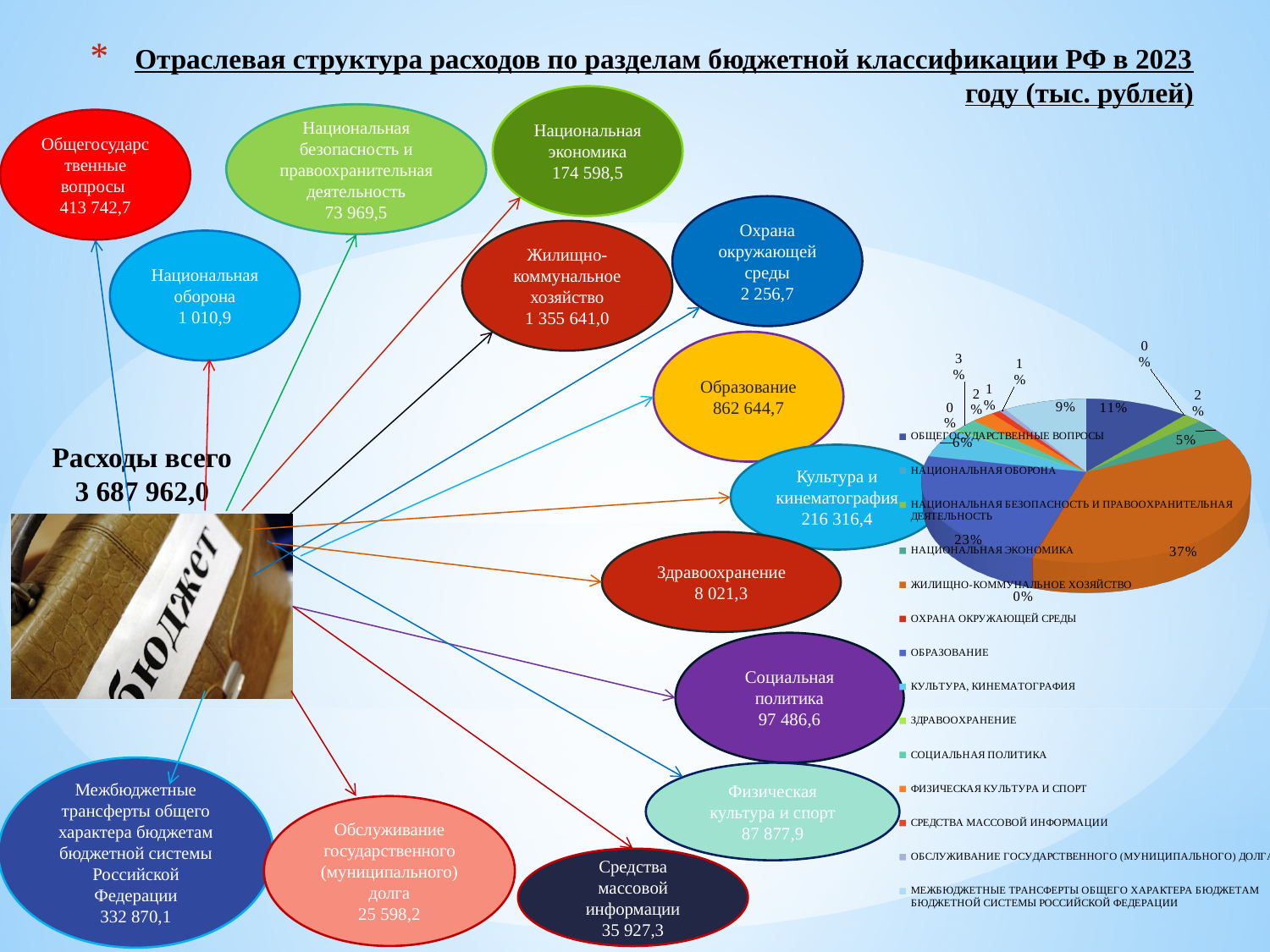
What share of the pie chart does Национальная экономика have? 5% What share of the pie chart does Общегосударственные вопросы have? 11% By how many percentage points does the share of Жилищно-коммунальное хозяйство exceed the share of Образование in the pie chart? 14 What share of the pie chart does Межбюджетные трансферты общего характера бюджетам бюджетной системы Российской Федерации have? 9% What kind of chart is shown on the right side of the slide? pie chart Which has the larger share in the pie chart, Жилищно-коммунальное хозяйство or Образование? Жилищно-коммунальное хозяйство What is the title of the slide containing the pie chart? Отраслевая структура расходов по разделам бюджетной классификации РФ в 2023 году (тыс. рублей) How many categories does the pie chart's legend list? 14 Which category has the largest share of the pie chart? Жилищно-коммунальное хозяйство What is the percentage label on the largest slice of the pie chart? 37% What is the first entry in the pie chart's legend? ОБЩЕГОСУДАРСТВЕННЫЕ ВОПРОСЫ